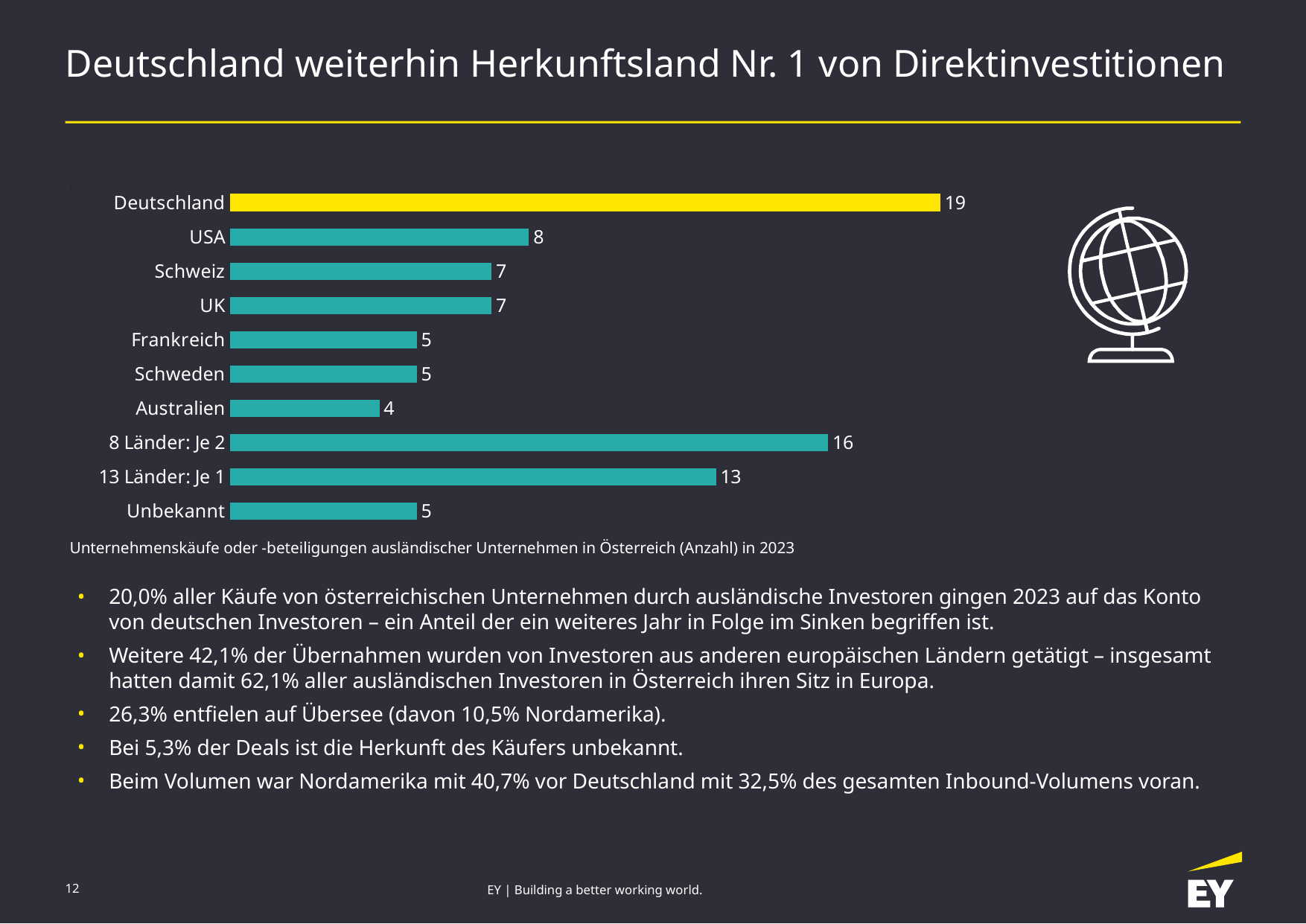
Which category has the lowest value? Australien Which category has the highest value? Deutschland Which is larger, the value for Schweiz or the value for Frankreich? Schweiz What is the value for Australien? 4 What kind of chart is shown on the slide? Bar chart What is the difference between the values for Deutschland and USA? 11 Which bar is highlighted in yellow? Deutschland What is the value for USA? 8 How many categories are shown in the chart? 10 What is the value for 13 Länder: Je 1? 13 What is the difference between the values for 8 Länder: Je 2 and 13 Länder: Je 1? 3 What is the value for Deutschland? 19